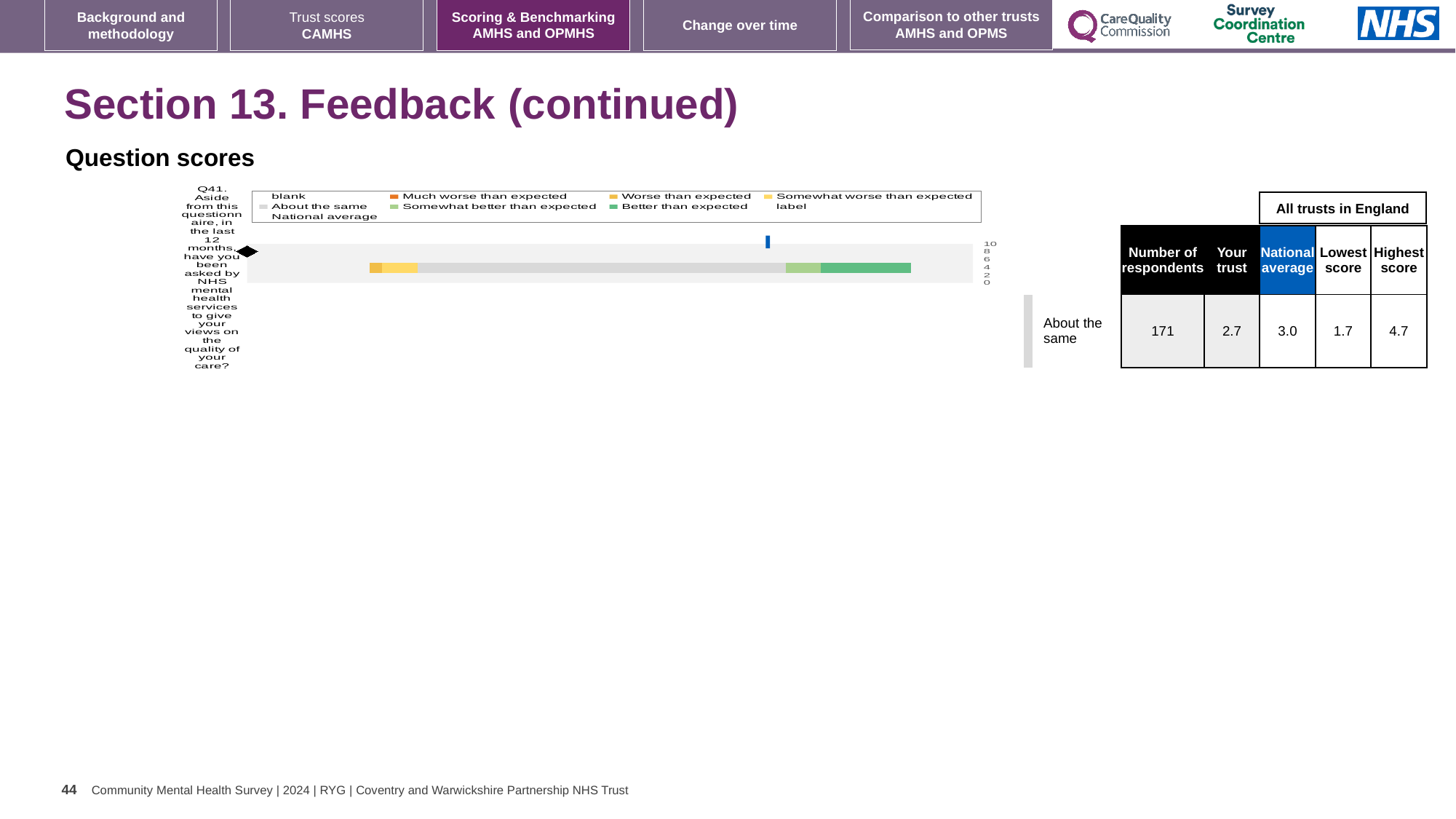
Which legend entry is shown in grey in the chart? About the same According to the table beside the chart, what is the national average score for Q41? 3.0 According to the table beside the chart, what is the highest score among all trusts in England for Q41? 4.7 According to the table beside the chart, what is the lowest score among all trusts in England for Q41? 1.7 Which legend entry is shown in dark blue in the chart? National average Is the trust's score for Q41 higher or lower than the national average? lower According to the table beside the chart, what is the trust's score for Q41? 2.7 What kind of chart is shown for Q41 on the slide? bar chart What is the difference between the highest score and the lowest score for Q41 in the table? 3.0 How many question categories are plotted in the chart? 1 According to the table beside the chart, what is the number of respondents for Q41? 171 How many entries does the chart's legend list? 9